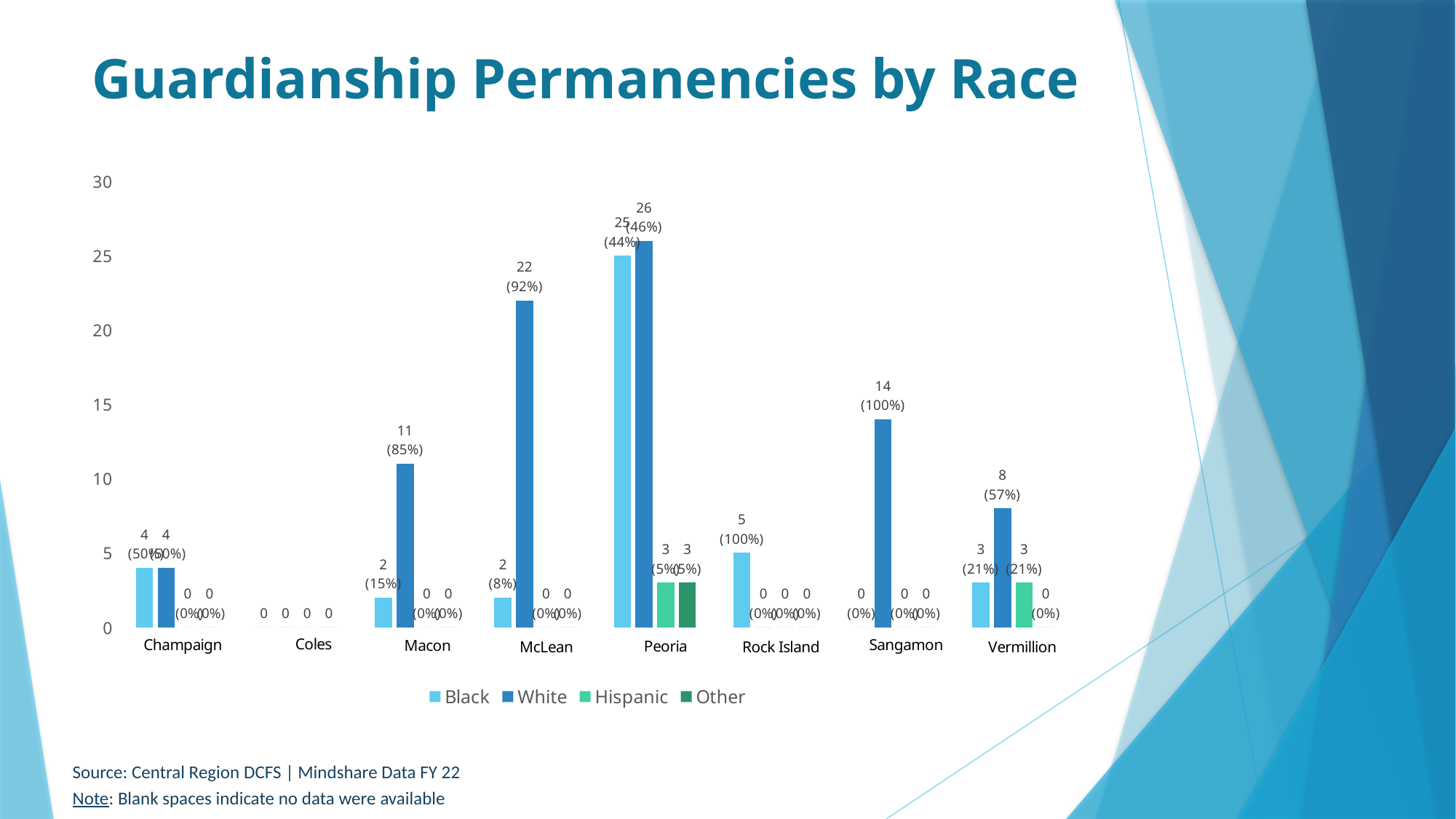
What type of chart is shown on the slide? Bar chart How many counties are shown on the x axis? 8 What is the value for Black in Peoria? 25 What is the difference between the White and Black values in Macon? 9 Which county has the highest White value? Peoria What is the value for White in McLean? 22 Which county has the highest Black value? Peoria What percentage is shown for White in Macon? 85% Which is larger in Vermillion, the White value or the Black value? White What is the title of the chart? Guardianship Permanencies by Race How many series does the legend list? 4 What is the value for Hispanic in Vermillion? 3